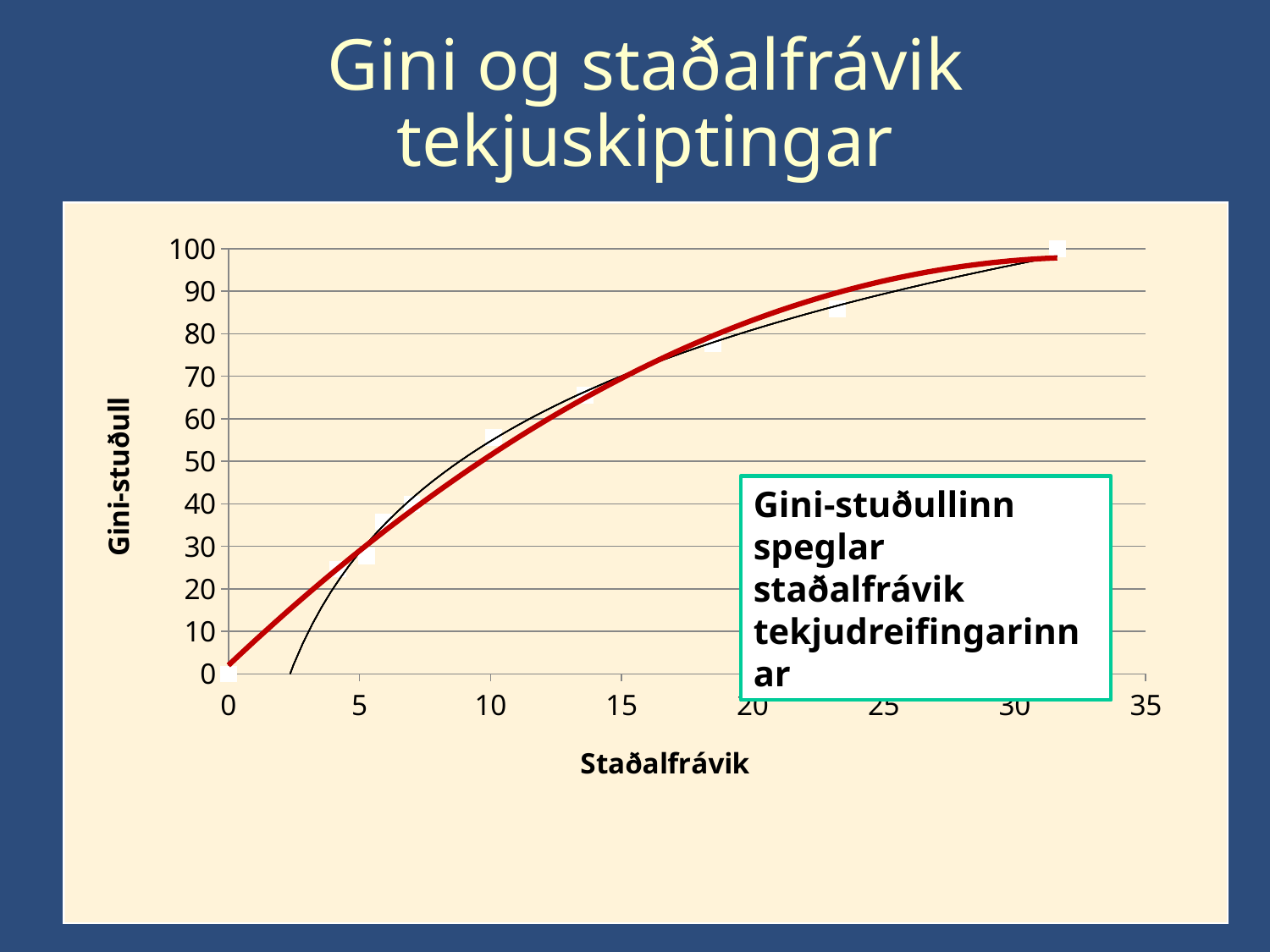
Is the value of the red curve at Staðalfrávik 5 greater or less than 20? greater Is the value of the red curve at Staðalfrávik 5 greater or less than 40? less Is the Gini-stuðull at Staðalfrávik 25 larger or smaller than at Staðalfrávik 10? larger Is the value of the red curve at Staðalfrávik 30 greater or less than 90? greater What is the highest value shown on the y axis? 100 What is the title of the slide's chart? Gini og staðalfrávik tekjuskiptingar Does the Gini-stuðull rise or fall as Staðalfrávik increases along the x axis? rise What is the label of the x axis? Staðalfrávik What kind of chart is shown on the slide? line chart